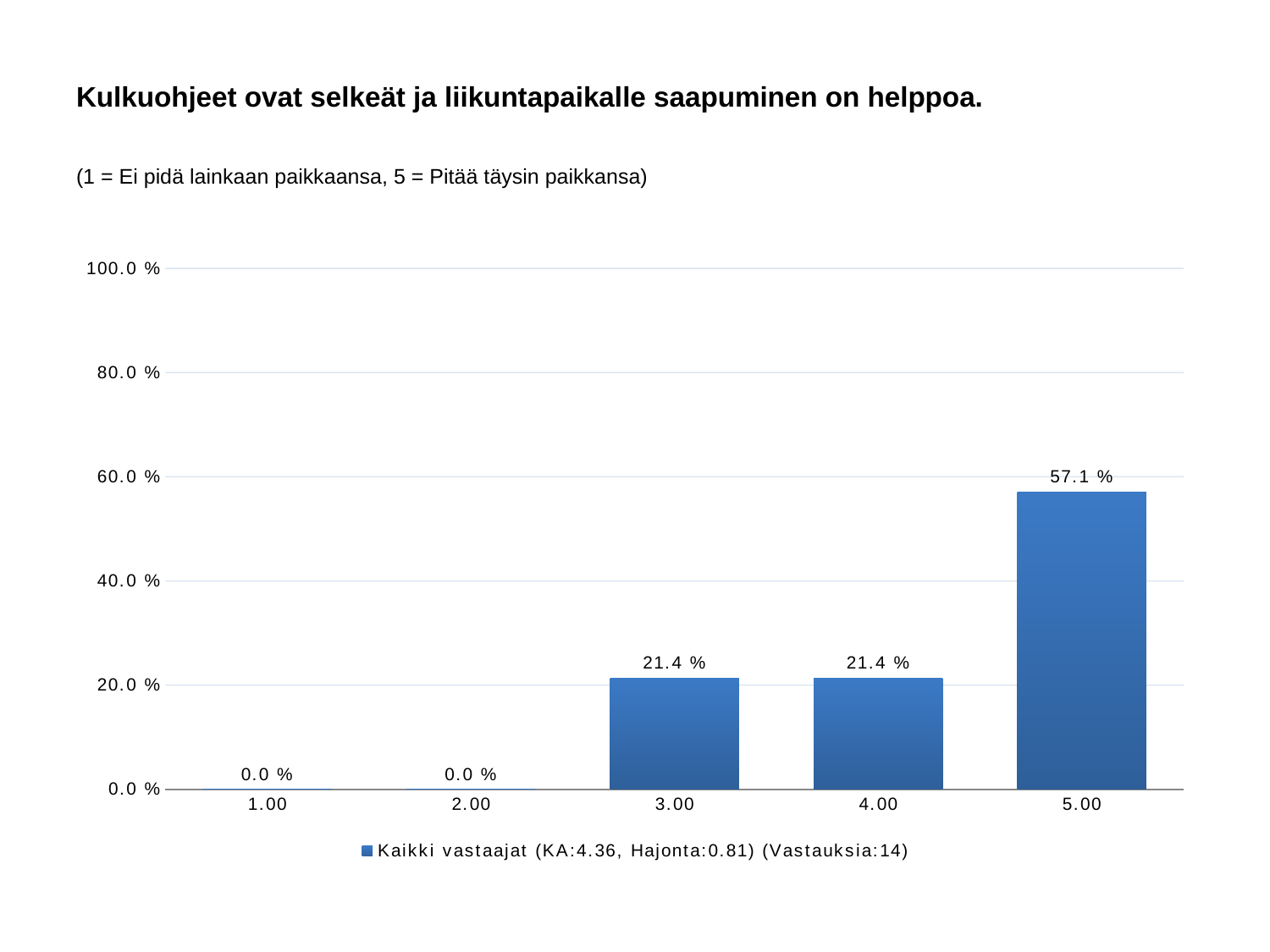
What is the value for category 1.00? 0.0 % Which is larger, the value for 3.00 or the value for 5.00? 5.00 Which category has the highest value? 5.00 Do the values rise or fall from category 1.00 to 5.00? rise How many responses (Vastauksia) does the legend report? 14 What kind of chart is shown? bar chart How many series does the legend list? 1 Is the value for 5.00 greater or less than 40.0 %? greater What is the value for category 5.00? 57.1 % What is the difference between the values for 5.00 and 4.00? 35.7 % What is the value for category 3.00? 21.4 % How many categories are shown on the x axis? 5